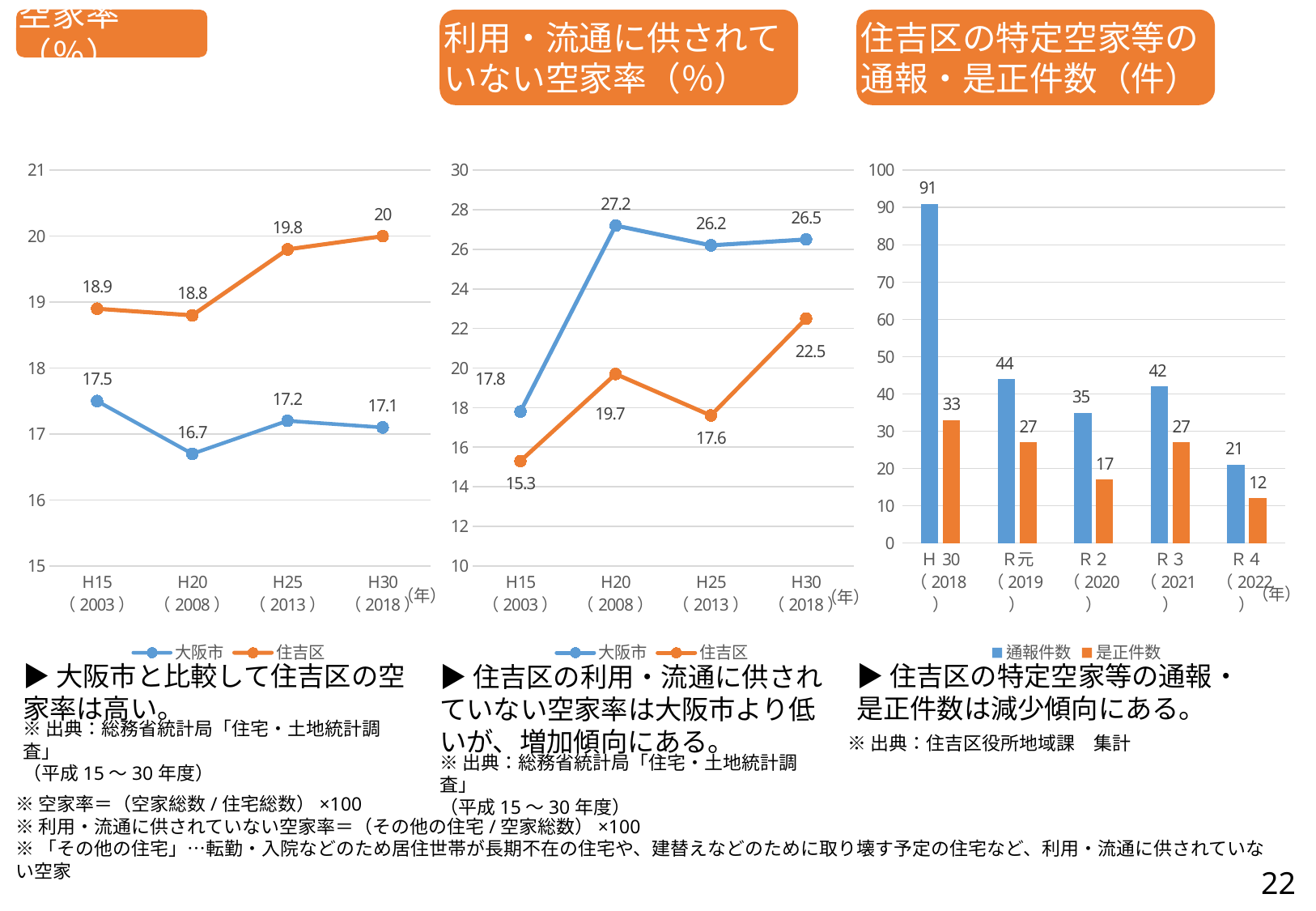
In the right chart (住吉区の特定空家等の通報・是正件数), what is the 通報件数 value for R3 (2021)? 42 In the right chart (住吉区の特定空家等の通報・是正件数), in which year is 通報件数 highest? H30 (2018) In the middle chart (利用・流通に供されていない空家率), what is the difference between 大阪市 and 住吉区 in H30 (2018)? 4 In the left chart (空家率), what is the difference between 住吉区 and 大阪市 in H15 (2003)? 1.4 What kind of chart is the right chart (住吉区の特定空家等の通報・是正件数)? bar chart In the middle chart (利用・流通に供されていない空家率), in which year is the 住吉区 value lowest? H15 (2003) In the left chart (空家率), which series has the higher value in H25 (2013), 大阪市 or 住吉区? 住吉区 In the left chart (空家率), what is the value for 大阪市 in H20 (2008)? 16.7 In the right chart (住吉区の特定空家等の通報・是正件数), what is the difference between 通報件数 and 是正件数 in R2 (2020)? 18 In the middle chart, how many series does the legend list? 2 In the middle chart (利用・流通に供されていない空家率), what is the value for 大阪市 in H20 (2008)? 27.2 In the left chart (空家率), what is the value for 住吉区 in H30 (2018)? 20